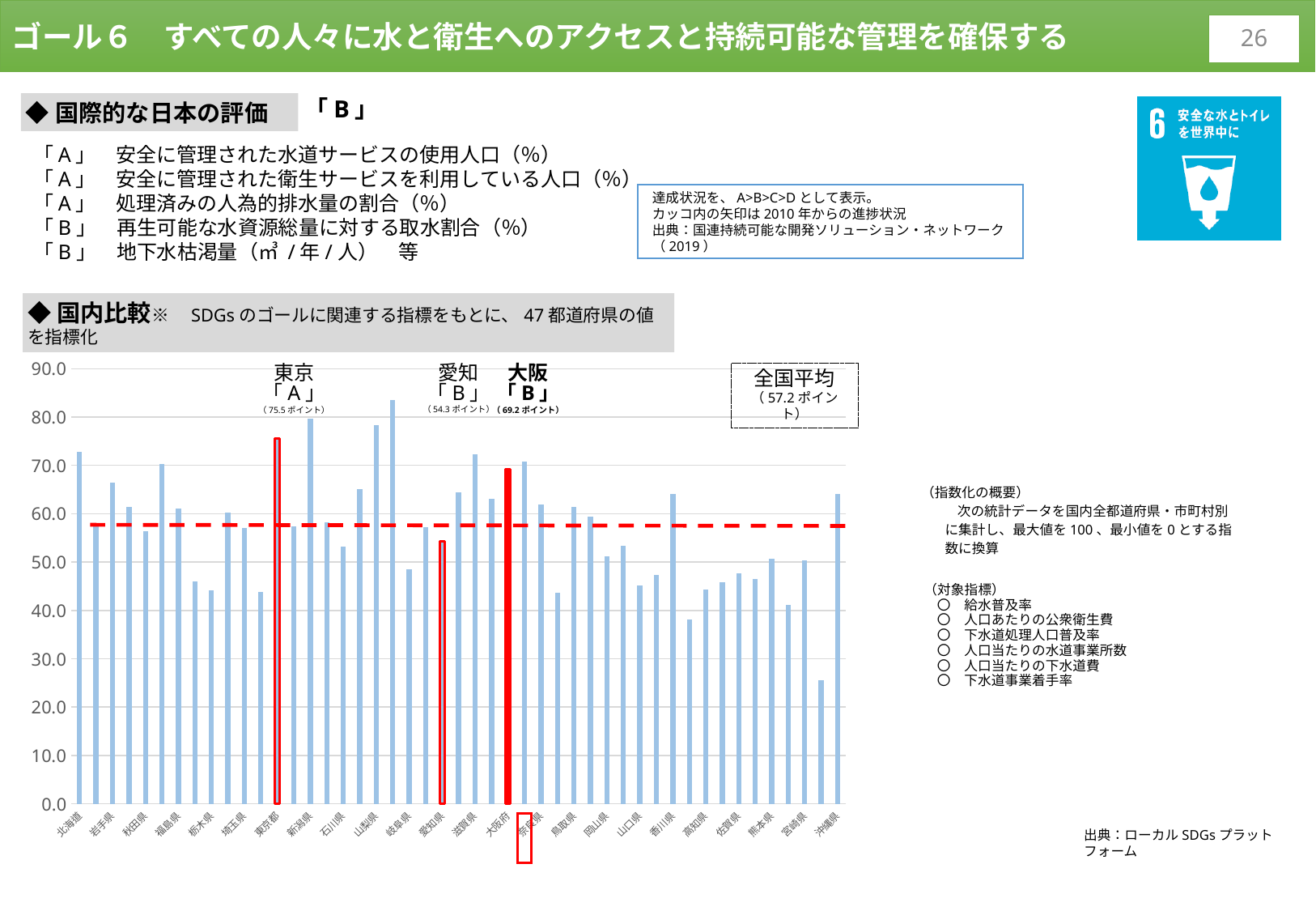
国内比較のグラフで、高知県の値は50.0より大きいですか、小さいですか？ 小さい 国内比較のグラフで、大阪と愛知の値の差は何ポイントですか？ 14.9ポイント 国内比較のグラフはどの種類のグラフですか？ 棒グラフ 国内比較のグラフで、愛知の値は何ポイントですか？ 54.3ポイント 国内比較のグラフで、新潟県の値は70.0より大きいですか、小さいですか？ 大きい 国内比較のグラフで、全国平均は何ポイントですか？ 57.2ポイント 国内比較のグラフで、大阪の値は何ポイントですか？ 69.2ポイント 国内比較のグラフで、東京と大阪ではどちらの値が大きいですか？ 東京 国内比較のグラフで、東京の値は何ポイントですか？ 75.5ポイント 国内比較のグラフの赤い点線は何を表していますか？ 全国平均 国内比較のグラフで、東京と大阪の値の差は何ポイントですか？ 6.3ポイント 国内比較のグラフで、愛知の値と全国平均ではどちらが大きいですか？ 全国平均